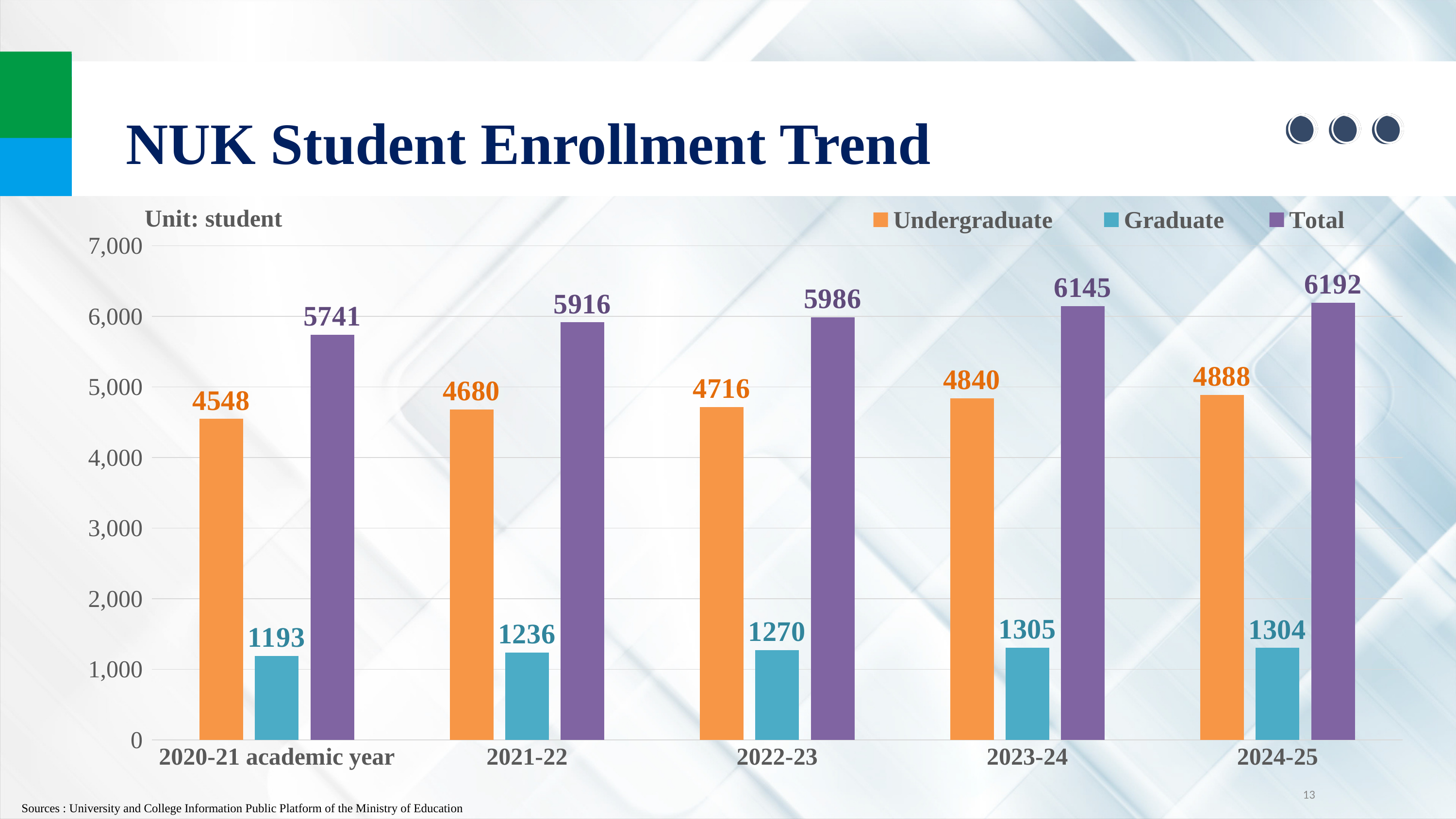
Which academic year has the lowest Undergraduate enrollment? 2020-21 academic year What is the difference between the Total enrollment in 2024-25 and in 2020-21? 451 Which academic year has the highest Total enrollment? 2024-25 What kind of chart is shown on the slide? bar chart How many series does the legend list? 3 Does the Total enrollment rise or fall from 2020-21 to 2024-25? rise Which is larger, the Graduate enrollment in 2023-24 or in 2024-25? 2023-24 What is the Total enrollment for the 2020-21 academic year? 5741 How many academic years are shown on the x axis? 5 Is the Undergraduate value for 2023-24 greater or less than 5,000? less What is the Graduate enrollment for 2024-25? 1304 What is the Undergraduate enrollment for the 2022-23 academic year? 4716